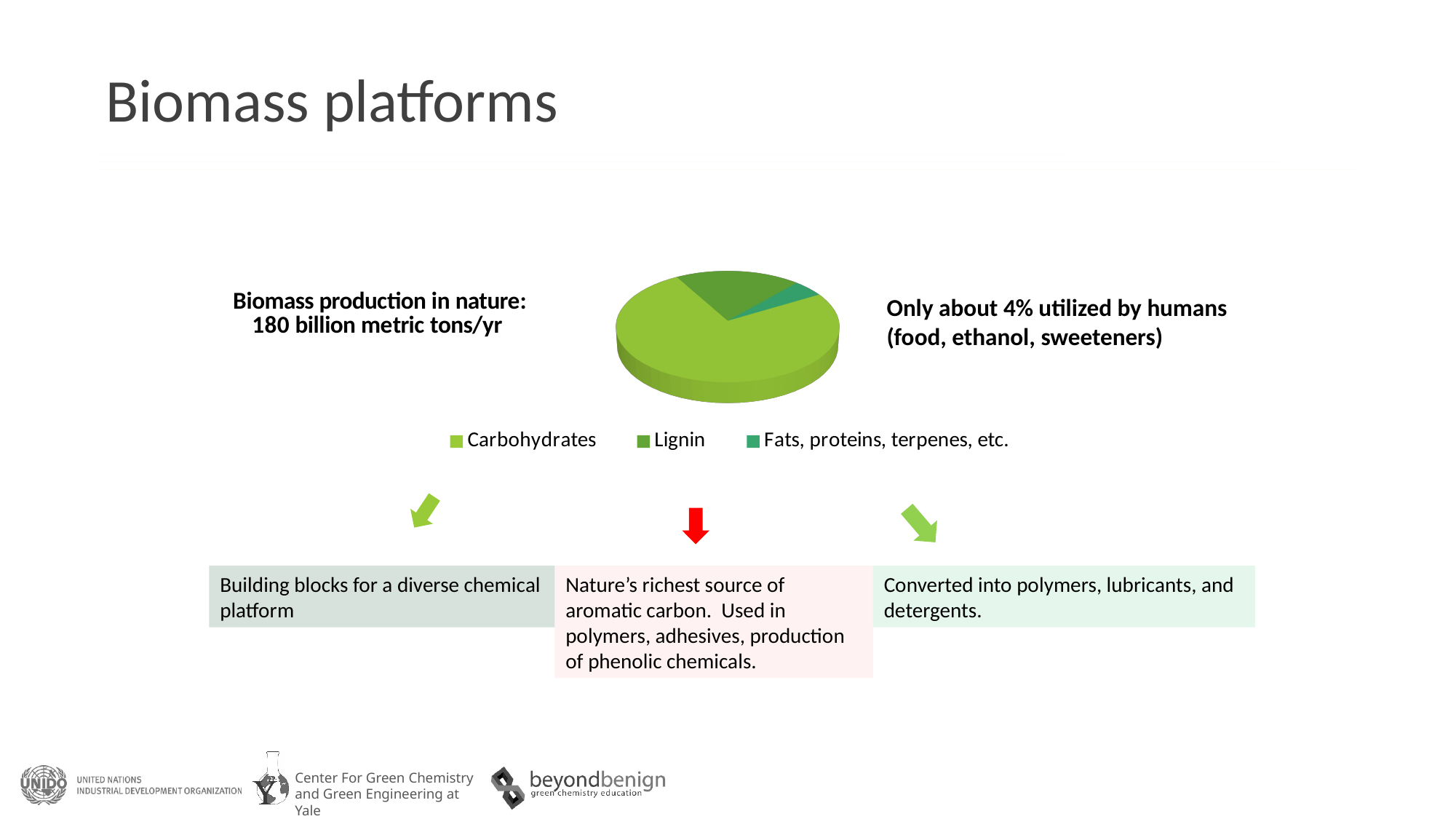
Which slice is larger in the pie chart, Carbohydrates or Lignin? Carbohydrates How many slices does the pie chart have? 3 Which slice is larger in the pie chart, Lignin or Fats, proteins, terpenes, etc.? Lignin What are the three categories listed in the pie chart's legend? Carbohydrates, Lignin, Fats, proteins, terpenes, etc. Which category has the largest slice of the pie chart? Carbohydrates Which category has the smallest slice of the pie chart? Fats, proteins, terpenes, etc. Which legend entry of the pie chart is shown in the lightest green colour? Carbohydrates Does the Carbohydrates slice make up more or less than half of the pie chart? more What kind of chart is shown on the slide? pie chart How many entries does the legend of the pie chart list? 3